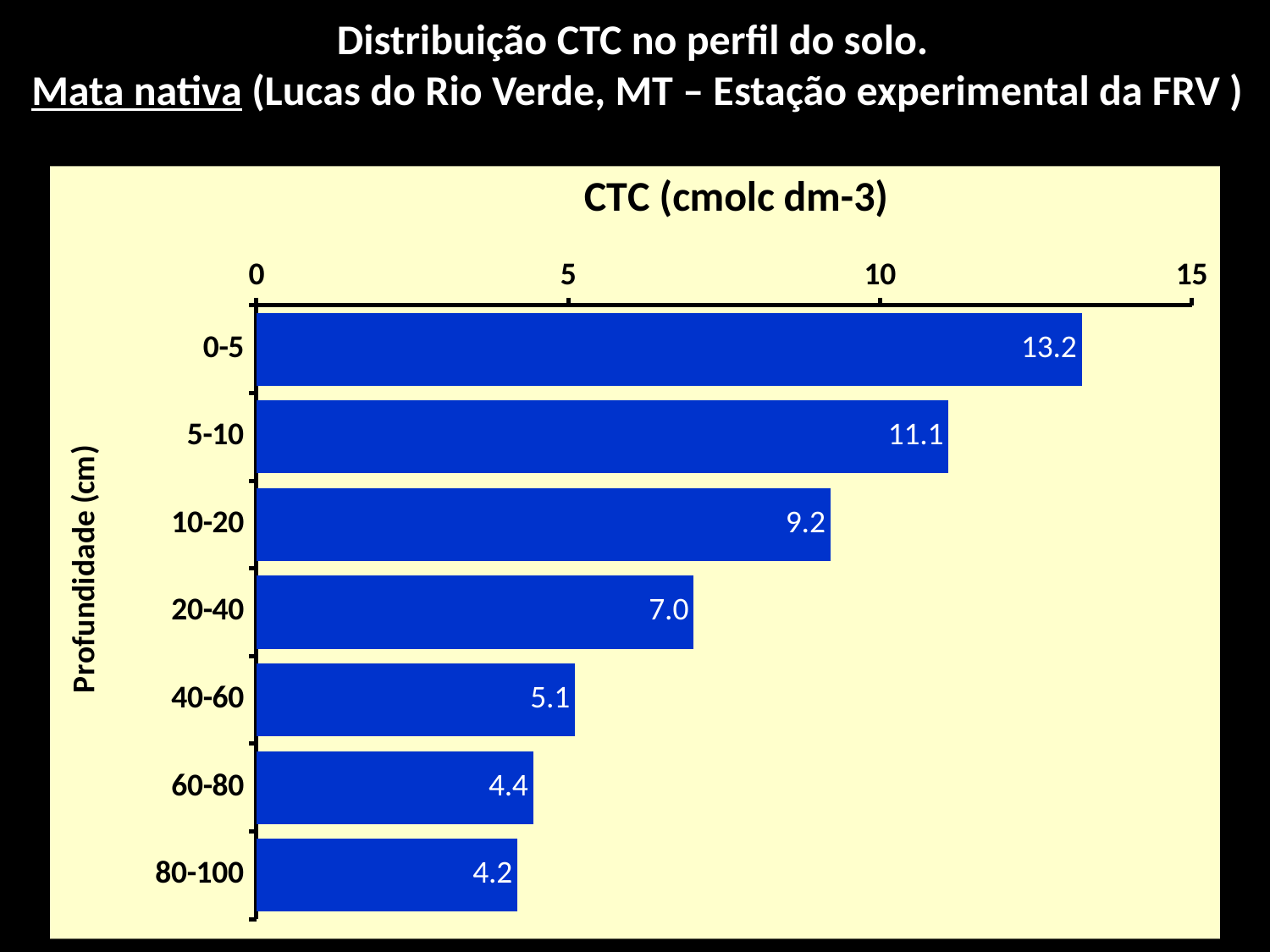
What is the difference between the CTC values for 0-5 cm and 5-10 cm? 2.1 Which depth has the lowest CTC value? 80-100 What is the CTC value for the 0-5 cm depth? 13.2 What is the title of the chart's value axis? CTC (cmolc dm-3) What is the CTC value for the 20-40 cm depth? 7.0 Is the CTC value for 5-10 cm greater or less than 10? greater How many depth categories are shown in the chart? 7 Which depth has the highest CTC value? 0-5 What kind of chart is shown on the slide? bar chart Which has a larger CTC value, 20-40 cm or 60-80 cm? 20-40 What is the difference between the CTC values for 10-20 cm and 40-60 cm? 4.1 What is the CTC value for the 80-100 cm depth? 4.2